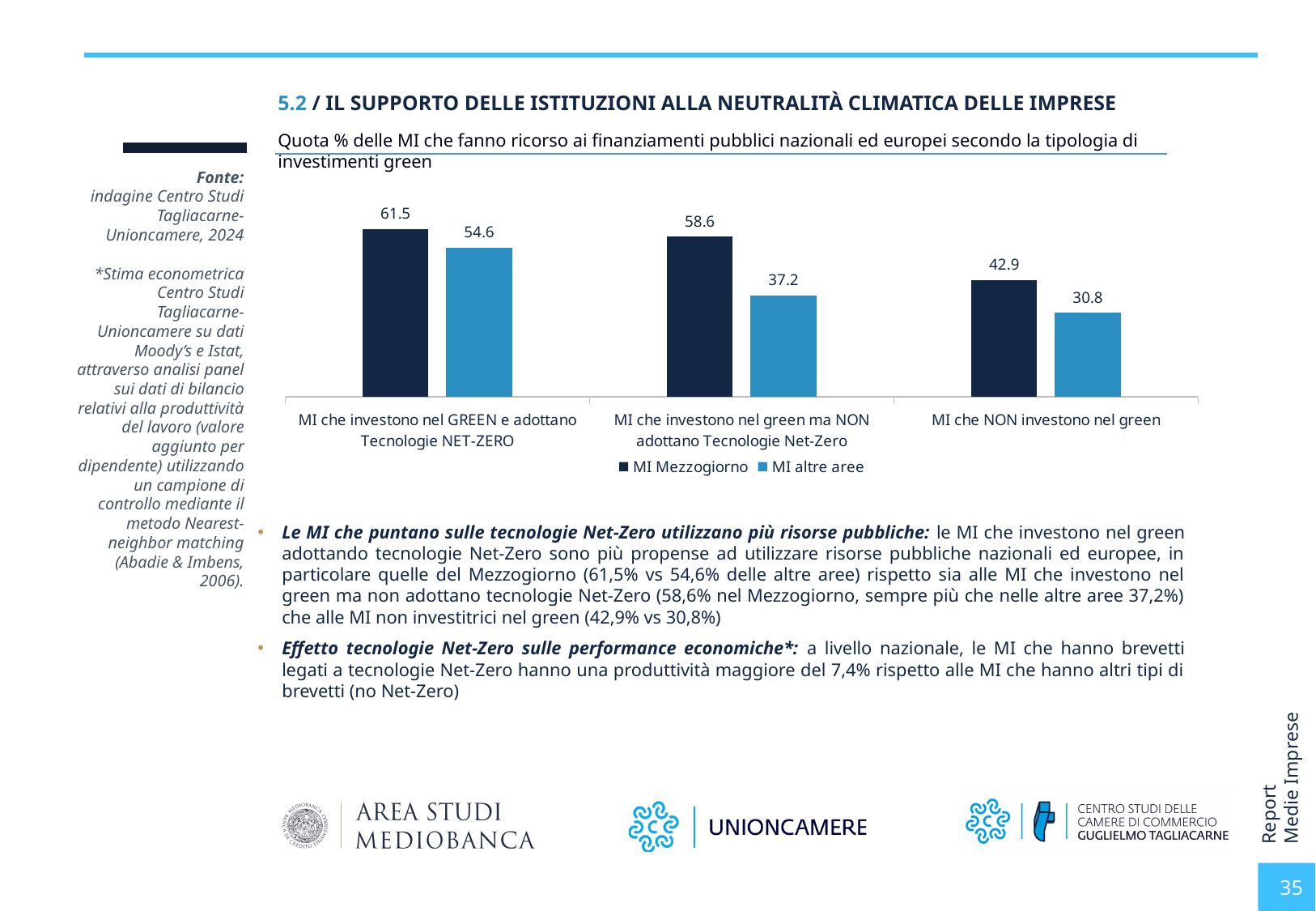
Do the values for MI Mezzogiorno rise or fall across the categories from left to right? Fall What is the value for MI altre aree in the category 'MI che investono nel green ma NON adottano Tecnologie Net-Zero'? 37.2 What is the value for MI altre aree in the category 'MI che NON investono nel green'? 30.8 What is the value for MI Mezzogiorno in the category 'MI che investono nel GREEN e adottano Tecnologie NET-ZERO'? 61.5 How many categories are shown on the x axis of the chart? 3 How many series does the legend list? 2 Which category has the highest value for MI Mezzogiorno? MI che investono nel GREEN e adottano Tecnologie NET-ZERO What is the difference between MI Mezzogiorno and MI altre aree in the category 'MI che investono nel green ma NON adottano Tecnologie Net-Zero'? 21.4 Which category has the lowest value for MI altre aree? MI che NON investono nel green Which is larger: MI altre aree for 'MI che investono nel GREEN e adottano Tecnologie NET-ZERO' or MI Mezzogiorno for 'MI che NON investono nel green'? MI altre aree for 'MI che investono nel GREEN e adottano Tecnologie NET-ZERO' What kind of chart is shown on the slide? Bar chart What is the difference between MI Mezzogiorno and MI altre aree in the category 'MI che NON investono nel green'? 12.1